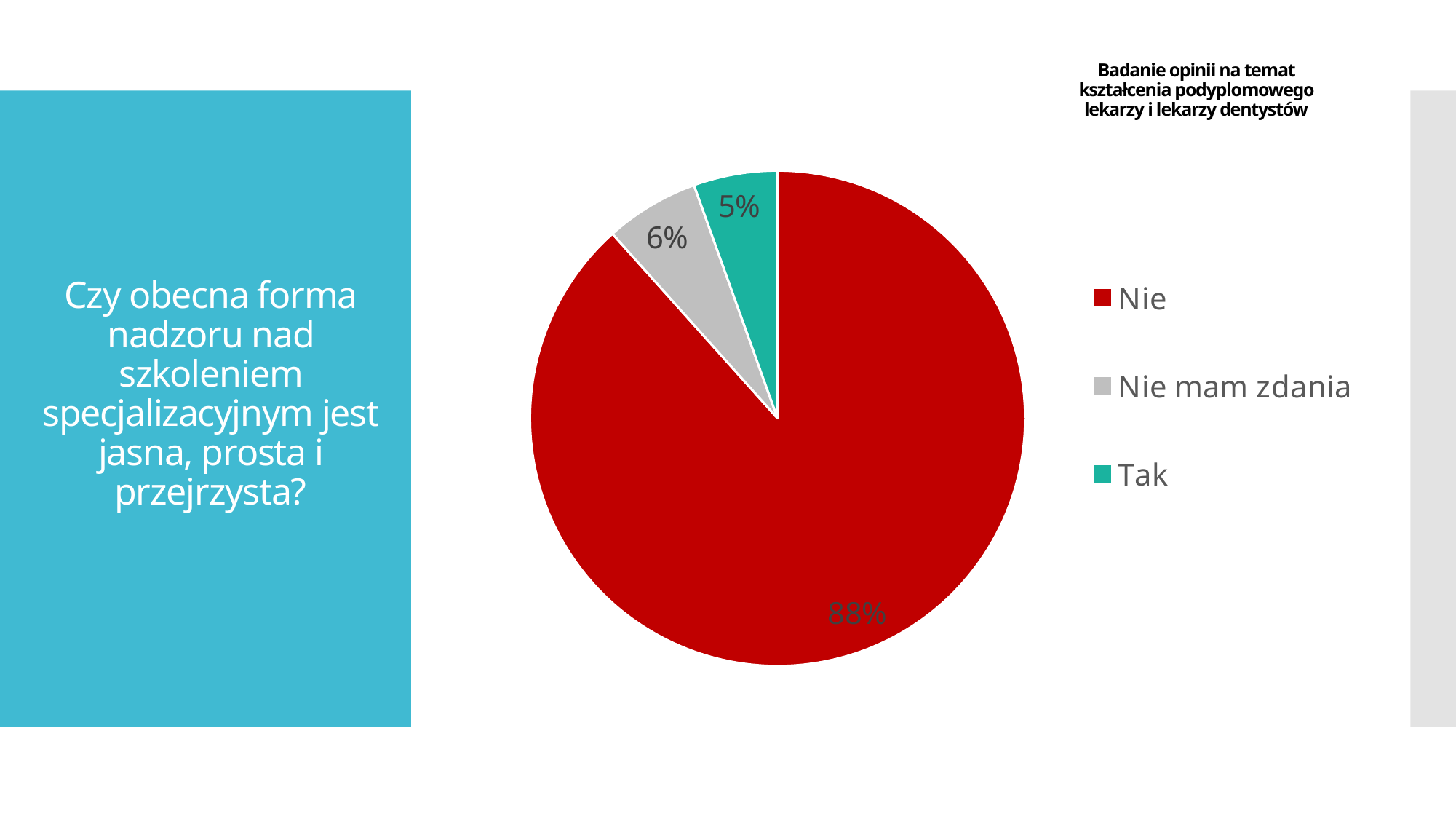
What percentage of respondents answered "Nie"? 88% How many slices does the pie chart have? 3 What kind of chart is shown on the slide? pie chart What is the difference in percentage points between "Nie mam zdania" and "Tak"? 1 What colour is the slice for "Tak"? teal/green What is the difference in percentage points between "Nie" and "Tak"? 83 Which is larger, the share for "Nie mam zdania" or the share for "Tak"? Nie mam zdania What percentage of respondents answered "Tak"? 5% How many entries does the legend list? 3 Which answer has the largest share of the pie? Nie Which answer has the smallest share of the pie? Tak What percentage of respondents answered "Nie mam zdania"? 6%